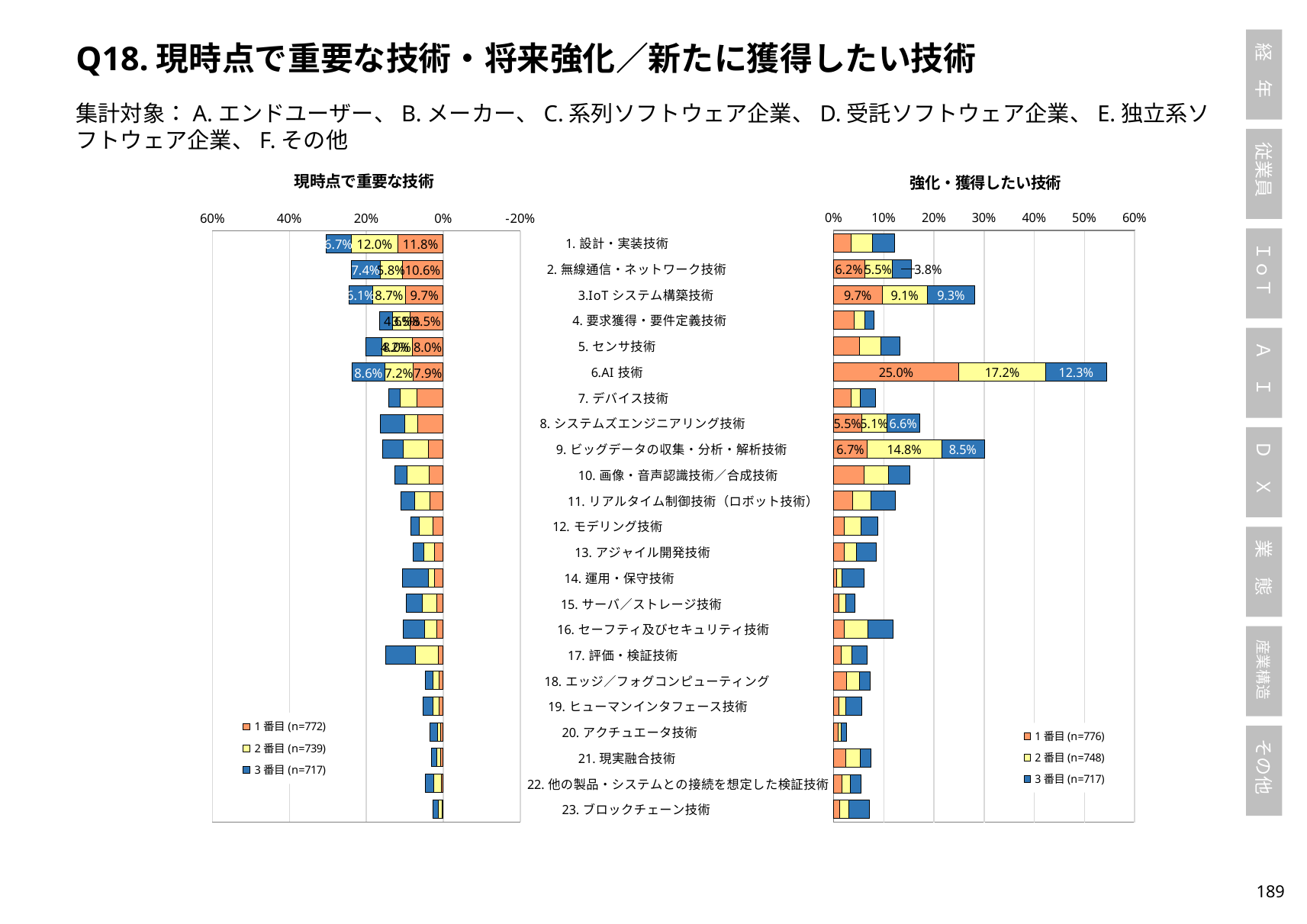
In the right chart (強化・獲得したい技術), what is the 1番目 value for 3.IoT システム構築技術? 9.7% In the right chart (強化・獲得したい技術), which category has the longest stacked bar? 6.AI 技術 In the right chart (強化・獲得したい技術), what is the total of the stacked bar for 6.AI 技術? 54.5% How many technology categories are listed in the left chart (現時点で重要な技術)? 23 In the right chart (強化・獲得したい技術), what is the 2番目 value for 9. ビッグデータの収集・分析・解析技術? 14.8% In the left chart (現時点で重要な技術), what is the 2番目 value for 1. 設計・実装技術? 12.0% In the right chart (強化・獲得したい技術), what is the 1番目 value for 6.AI 技術? 25.0% How many series does the legend of the right chart (強化・獲得したい技術) list? 3 In the left chart (現時点で重要な技術), what is the 3番目 value for 6.AI 技術? 8.6% In the right chart (強化・獲得したい技術), what is the difference between the 1番目 and 2番目 values for 6.AI 技術? 7.8% In the right chart (強化・獲得したい技術), what is the 2番目 value for 6.AI 技術? 17.2% In the right chart (強化・獲得したい技術), is the 1番目 value for 6.AI 技術 larger than the 1番目 value for 9. ビッグデータの収集・分析・解析技術? Yes